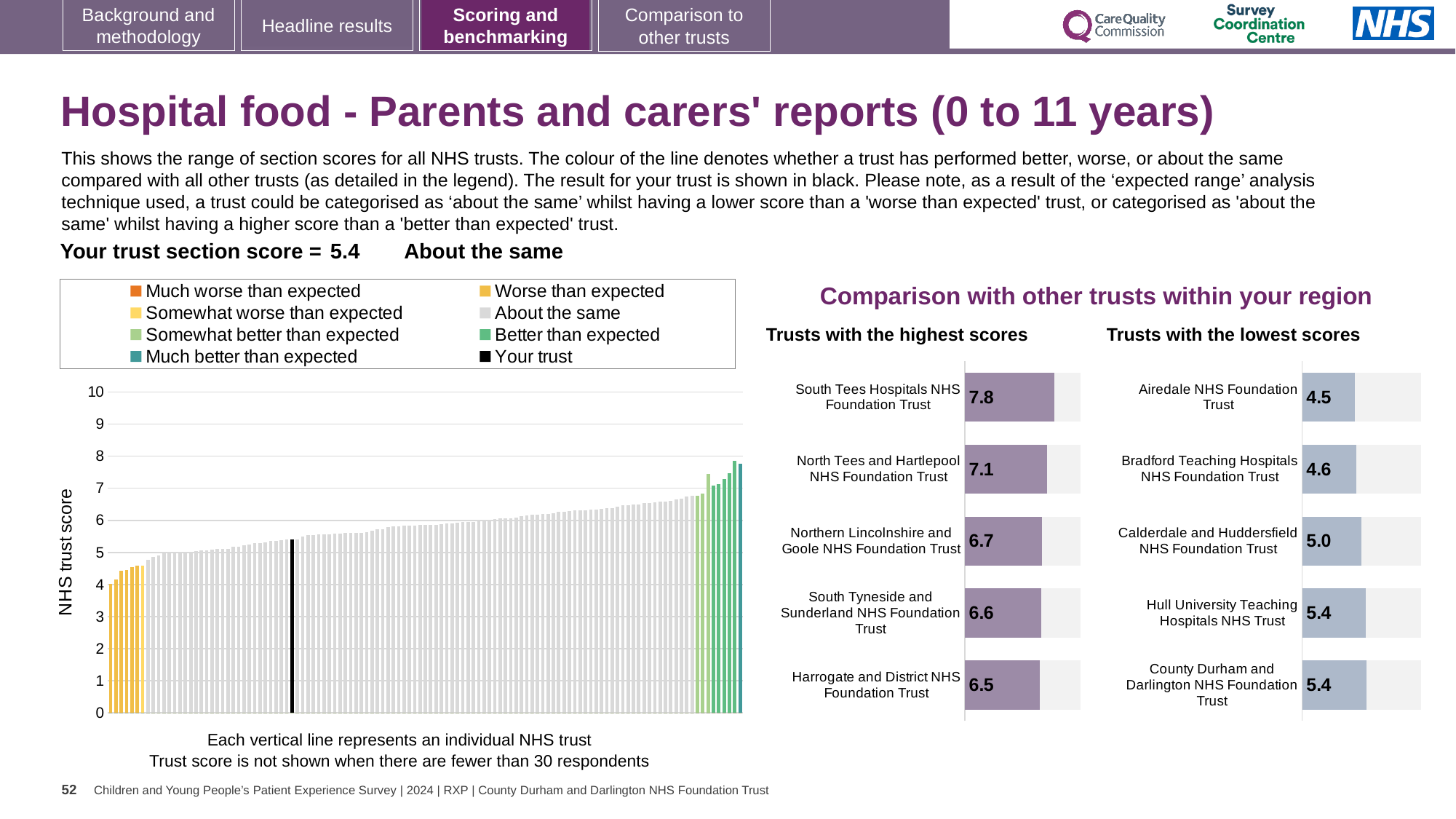
In the 'Trusts with the lowest scores' chart, what is the difference between the scores of Hull University Teaching Hospitals NHS Trust and Airedale NHS Foundation Trust? 0.9 In the main chart on the left showing the range of NHS trust scores, do the bars rise or fall from left to right? rise How many trusts are shown in the 'Trusts with the highest scores' chart? 5 In the 'Trusts with the highest scores' chart, what is the score for South Tees Hospitals NHS Foundation Trust? 7.8 In the 'Trusts with the highest scores' chart, which trust has the highest score? South Tees Hospitals NHS Foundation Trust How many entries does the legend of the main chart on the left list? 8 In the 'Trusts with the highest scores' chart, what is the score for Harrogate and District NHS Foundation Trust? 6.5 In the main chart on the left showing the range of NHS trust scores, what is the score for your trust (the black bar)? 5.4 In the 'Trusts with the lowest scores' chart, which trust has the lowest score? Airedale NHS Foundation Trust In the 'Trusts with the lowest scores' chart, what is the score for Calderdale and Huddersfield NHS Foundation Trust? 5.0 In the 'Trusts with the highest scores' chart, what is the difference between the scores of South Tees Hospitals NHS Foundation Trust and Harrogate and District NHS Foundation Trust? 1.3 In the 'Trusts with the lowest scores' chart, which has the larger score: Bradford Teaching Hospitals NHS Foundation Trust or Calderdale and Huddersfield NHS Foundation Trust? Calderdale and Huddersfield NHS Foundation Trust